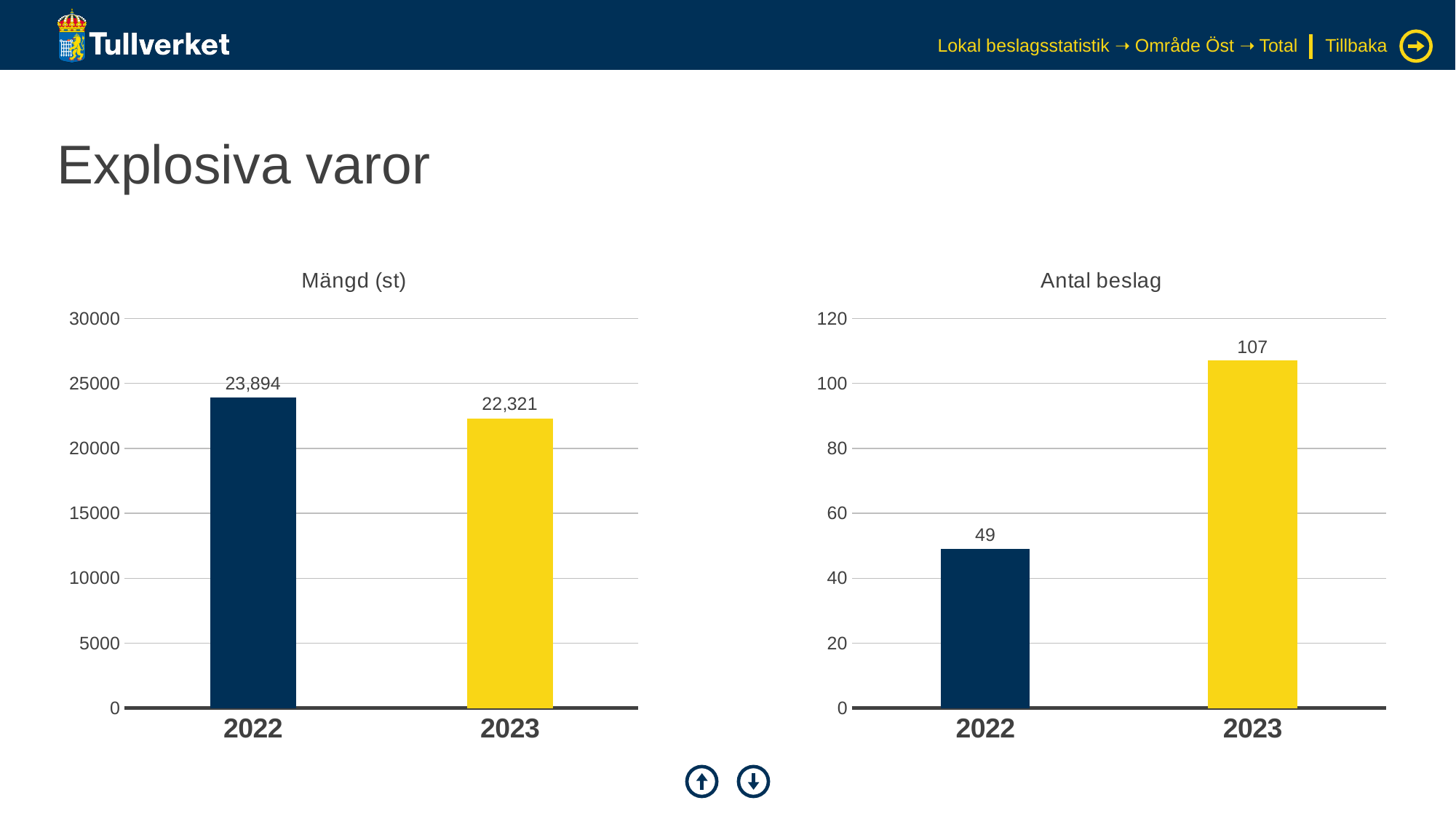
In the 'Mängd (st)' chart, what is the difference between the 2022 and 2023 values? 1,573 In the 'Antal beslag' chart, what is the value for 2022? 49 In the 'Antal beslag' chart, do the values rise or fall from 2022 to 2023? rise In the 'Antal beslag' chart, which year has the lower value? 2022 How many charts are shown on the slide? 2 In the 'Mängd (st)' chart, what is the value for 2023? 22,321 In the 'Mängd (st)' chart, what is the value for 2022? 23,894 What kind of chart is the 'Mängd (st)' chart? bar chart In the 'Antal beslag' chart, is the value for 2023 greater or less than 100? greater In the 'Antal beslag' chart, what is the value for 2023? 107 In the 'Antal beslag' chart, what is the difference between the 2023 and 2022 values? 58 In the 'Mängd (st)' chart, which year has the higher value? 2022